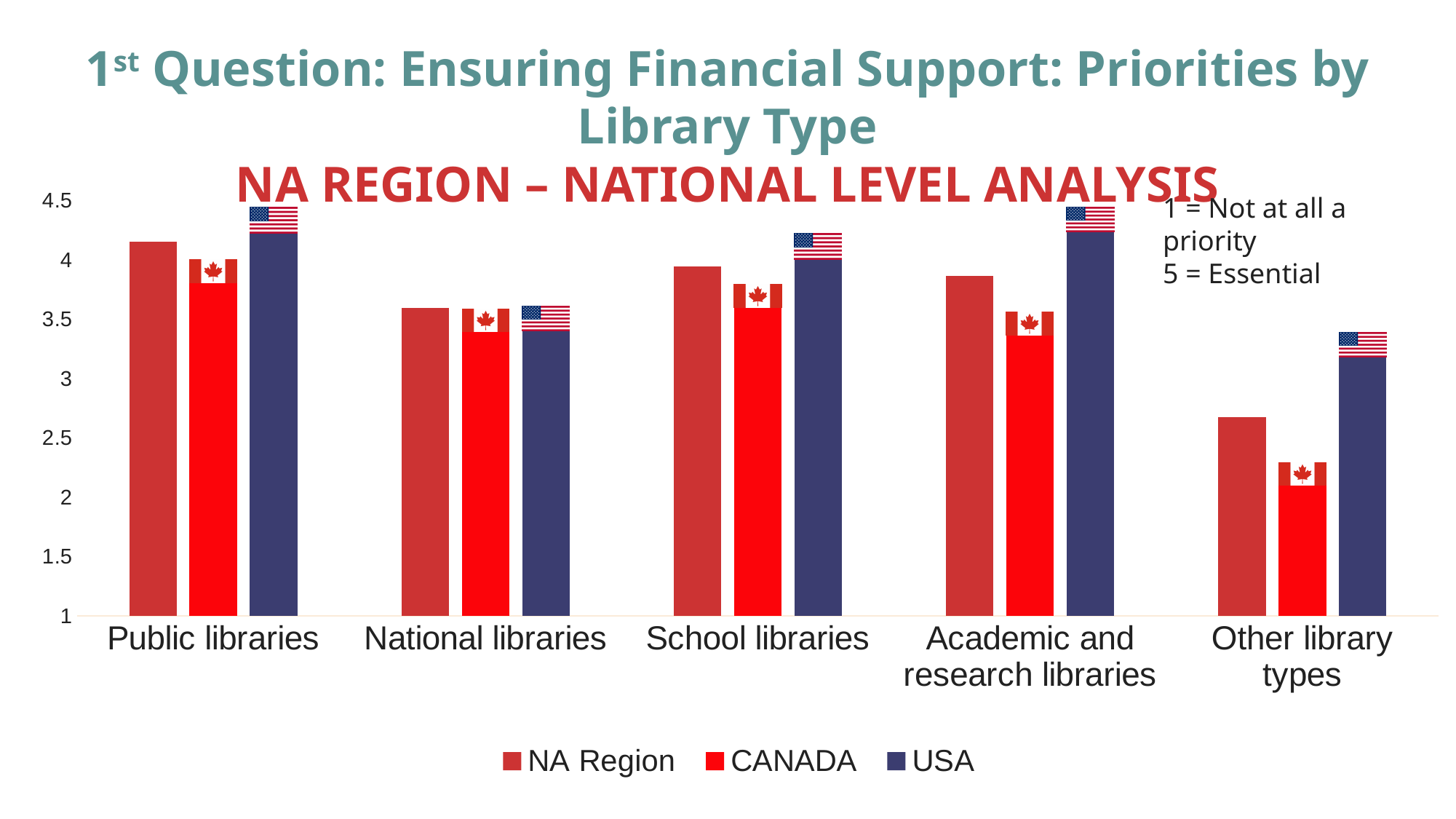
What kind of chart is shown on the slide? bar chart Is the CANADA value for Academic and research libraries greater or less than 4? less How many series does the legend list? 3 Which library type has the lowest NA Region value? Other library types How many library type categories are shown on the x axis? 5 Which library type has the highest CANADA value? Public libraries According to the note on the slide, what does a value of 5 mean? Essential Is the USA value for Other library types greater or less than 3? greater Is the CANADA value for Other library types greater or less than 2.5? less For Other library types, which is larger: the USA value or the CANADA value? USA For Academic and research libraries, which is larger: the USA value or the CANADA value? USA